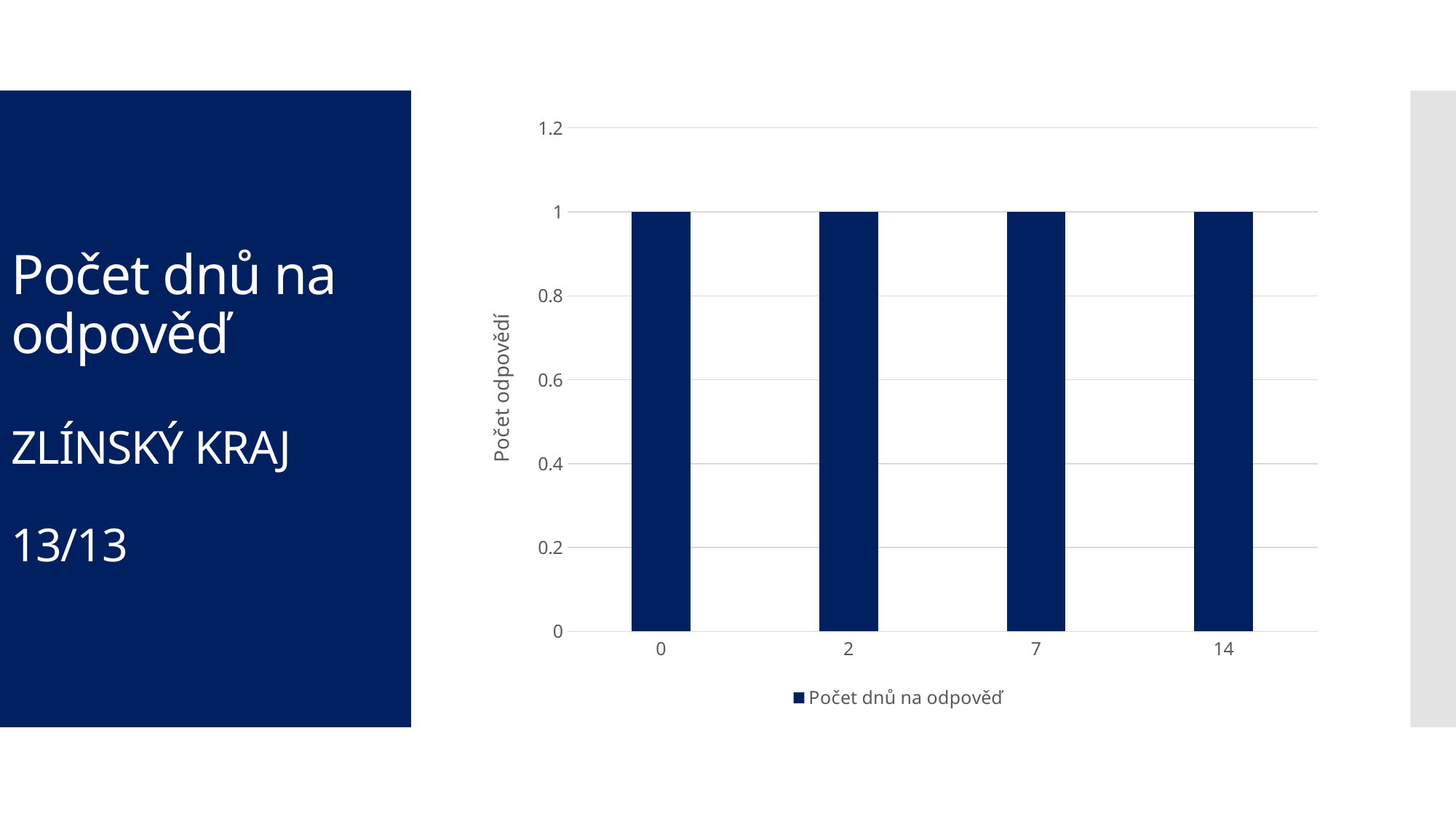
What is the label of the vertical axis of the chart? Počet odpovědí What is the value for category 7 in the chart? 1 What is the value for category 0 in the chart? 1 Is the value for category 2 greater or less than 0.8? greater What is the name of the series shown in the chart legend? Počet dnů na odpověď What is the difference between the values for category 2 and category 7? 0 Do the values rise, fall, or stay the same across the categories from 0 to 14? stay the same What kind of chart is shown on the slide? bar chart What is the value for category 14 in the chart? 1 How many categories are shown on the x axis of the chart? 4 How many series does the chart legend list? 1 Is the value for category 14 greater or less than 1.2? less